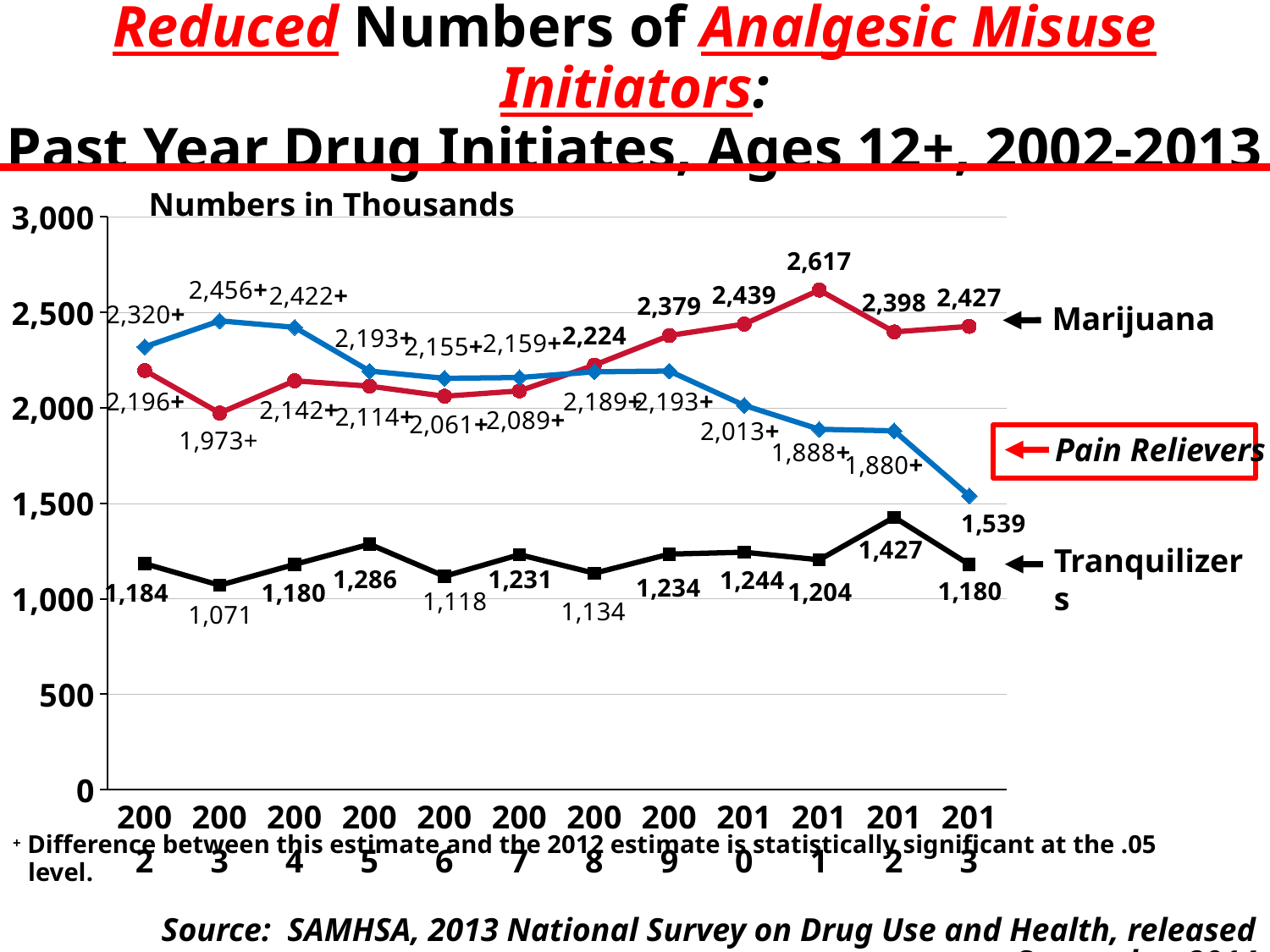
In 2013, which is larger: the Marijuana value or the Pain Relievers value? Marijuana What is the difference between the Pain Relievers value in 2003 and in 2013? 917 How many series are plotted on the chart? 3 Does the Pain Relievers series rise or fall from 2009 to 2013? Fall In which year is the Tranquilizers series at its lowest? 2003 What is the value for Pain Relievers in 2013? 1,539 What type of chart is shown on the slide? Line chart What is the value for Tranquilizers in 2012? 1,427 In which year is the Marijuana series at its highest? 2011 Is the value for Tranquilizers in 2005 greater or less than 1,500? less What is the value for Marijuana in 2011? 2,617 How many years are plotted along the x axis? 12